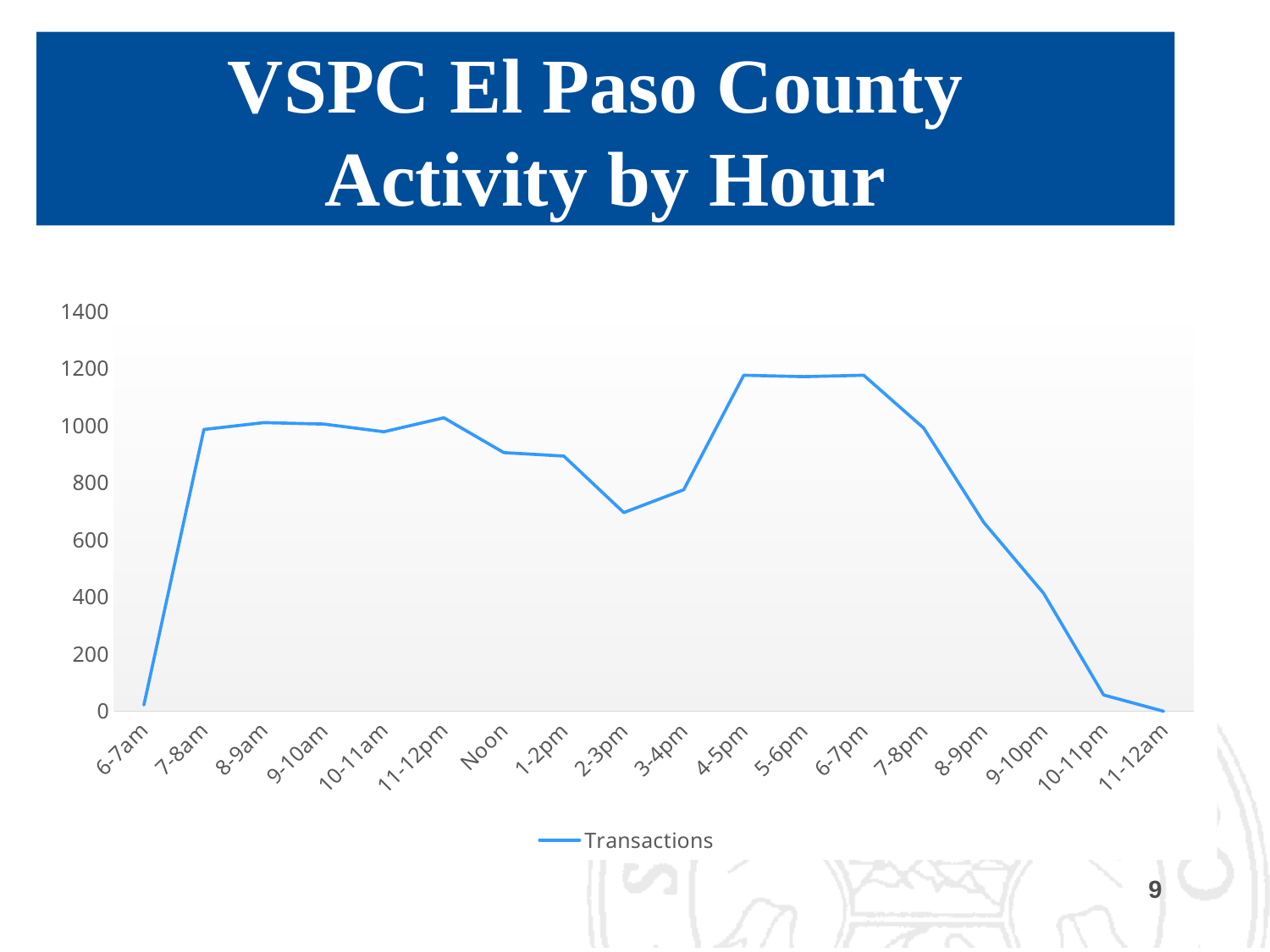
Is the value for 4-5pm greater or less than 1000? greater What kind of chart is shown on the slide? line chart Is the value for 2-3pm greater or less than 800? less What is the name of the series shown in the legend? Transactions How many series does the legend list? 1 Is the value for 6-7am greater or less than 200? less How many hourly categories are plotted along the x axis? 18 Which has more transactions, 8-9pm or 9-10pm? 8-9pm Which has more transactions, 4-5pm or 2-3pm? 4-5pm Do the values rise or fall from 6-7pm through 11-12am? fall